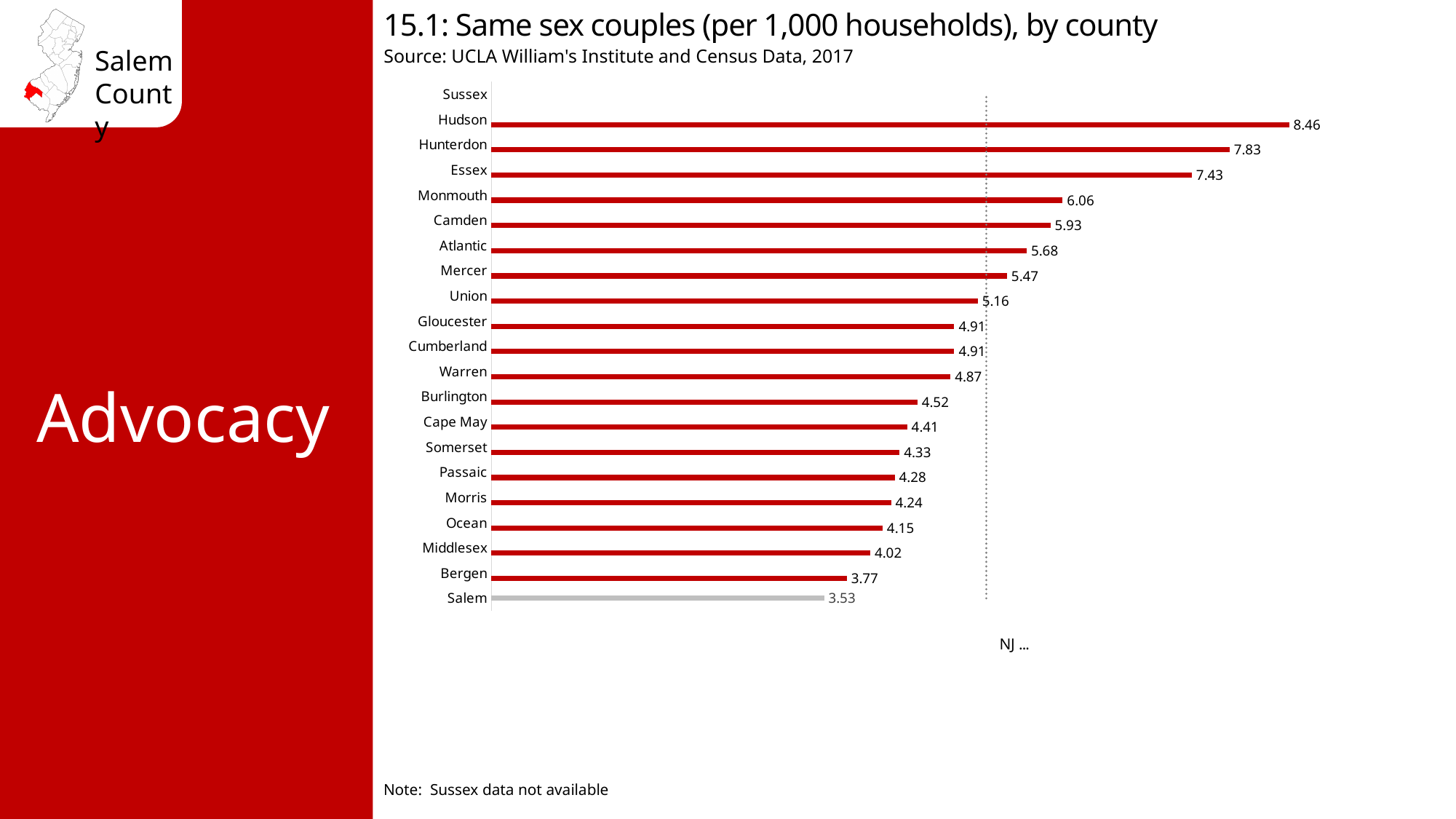
What is the difference between the values for Essex and Monmouth? 1.37 Which county with a plotted bar has the lowest value? Salem What is the value for Camden? 5.93 How many counties are listed on the y axis? 21 Which county has the highest value? Hudson Which is larger, the value for Mercer or the value for Union? Mercer What is the difference between the values for Hudson and Salem? 4.93 Which is larger, the value for Bergen or the value for Middlesex? Middlesex What is the value for Hudson? 8.46 What is the value for Salem? 3.53 Which county has no data shown, according to the note? Sussex What kind of chart is this? Bar chart